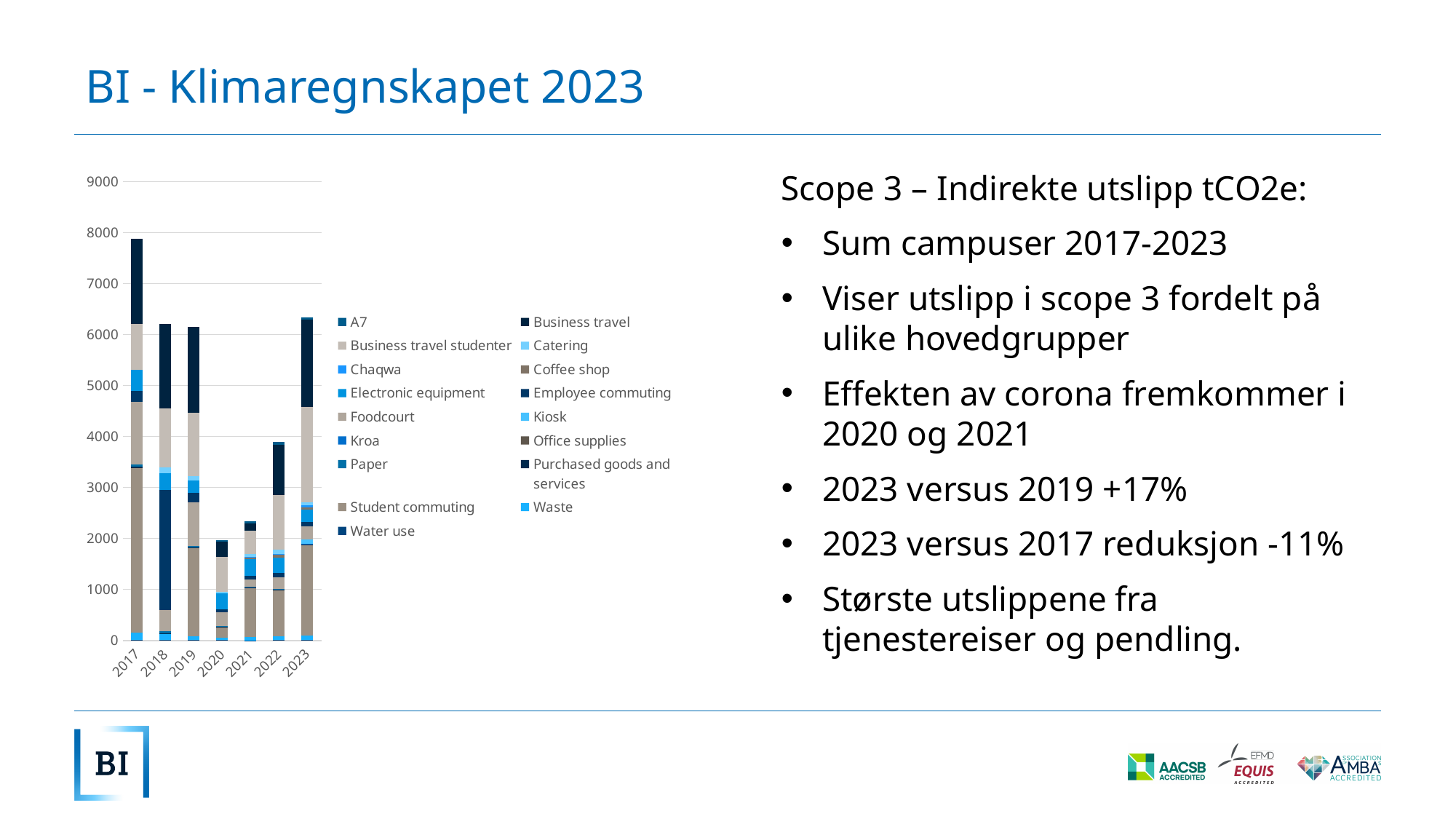
Which year has the lowest total stacked bar? 2020 How many series does the chart's legend list? 17 Is the total for 2022 greater or less than 3000? greater What kind of chart is shown on the slide? Stacked bar chart Which year has the highest total stacked bar? 2017 Do the total bars rise or fall from 2020 to 2023? rise Which year has the larger total, 2017 or 2023? 2017 Is the total for 2020 greater or less than 3000? less How many years are shown on the x axis of the chart? 7 Is the total for 2017 greater or less than 7000? greater What is the highest value shown on the chart's y axis? 9000